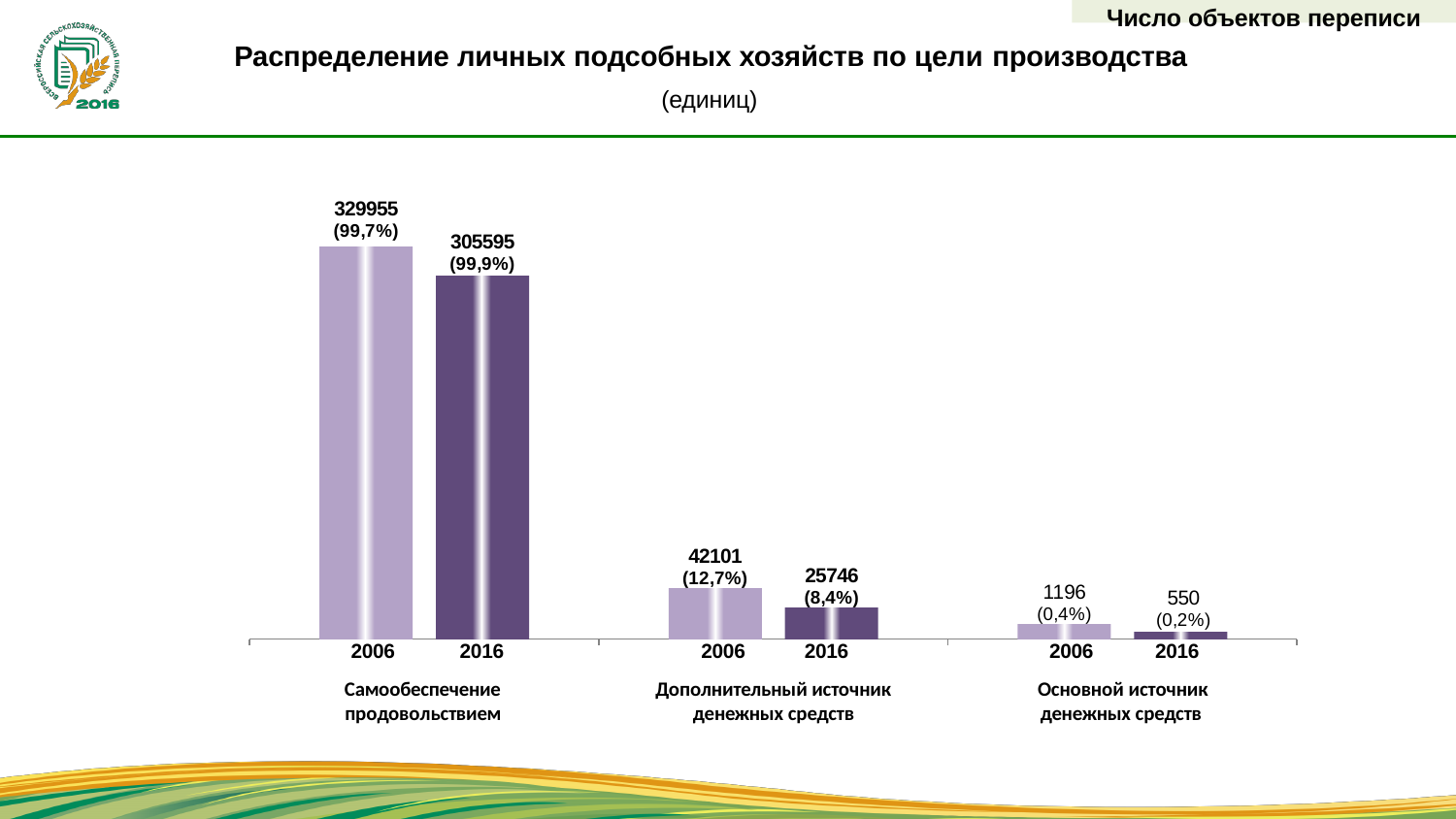
What is the value for 2016 in the "Дополнительный источник денежных средств" group? 25746 What is the value for 2016 in the "Основной источник денежных средств" group? 550 What is the difference between the 2006 and 2016 values in the "Дополнительный источник денежных средств" group? 16355 Which bar has the highest value on the chart? 2006, Самообеспечение продовольствием Which bar has the lowest value on the chart? 2016, Основной источник денежных средств How many bars are plotted on the chart? 6 What is the value for 2016 in the "Самообеспечение продовольствием" group? 305595 What is the value for 2006 in the "Самообеспечение продовольствием" group? 329955 What type of chart is shown on the slide? Bar chart Which is larger in the "Самообеспечение продовольствием" group: the 2006 value or the 2016 value? 2006 What is the value for 2006 in the "Дополнительный источник денежных средств" group? 42101 What percentage is shown for 2006 in the "Основной источник денежных средств" group? 0,4%